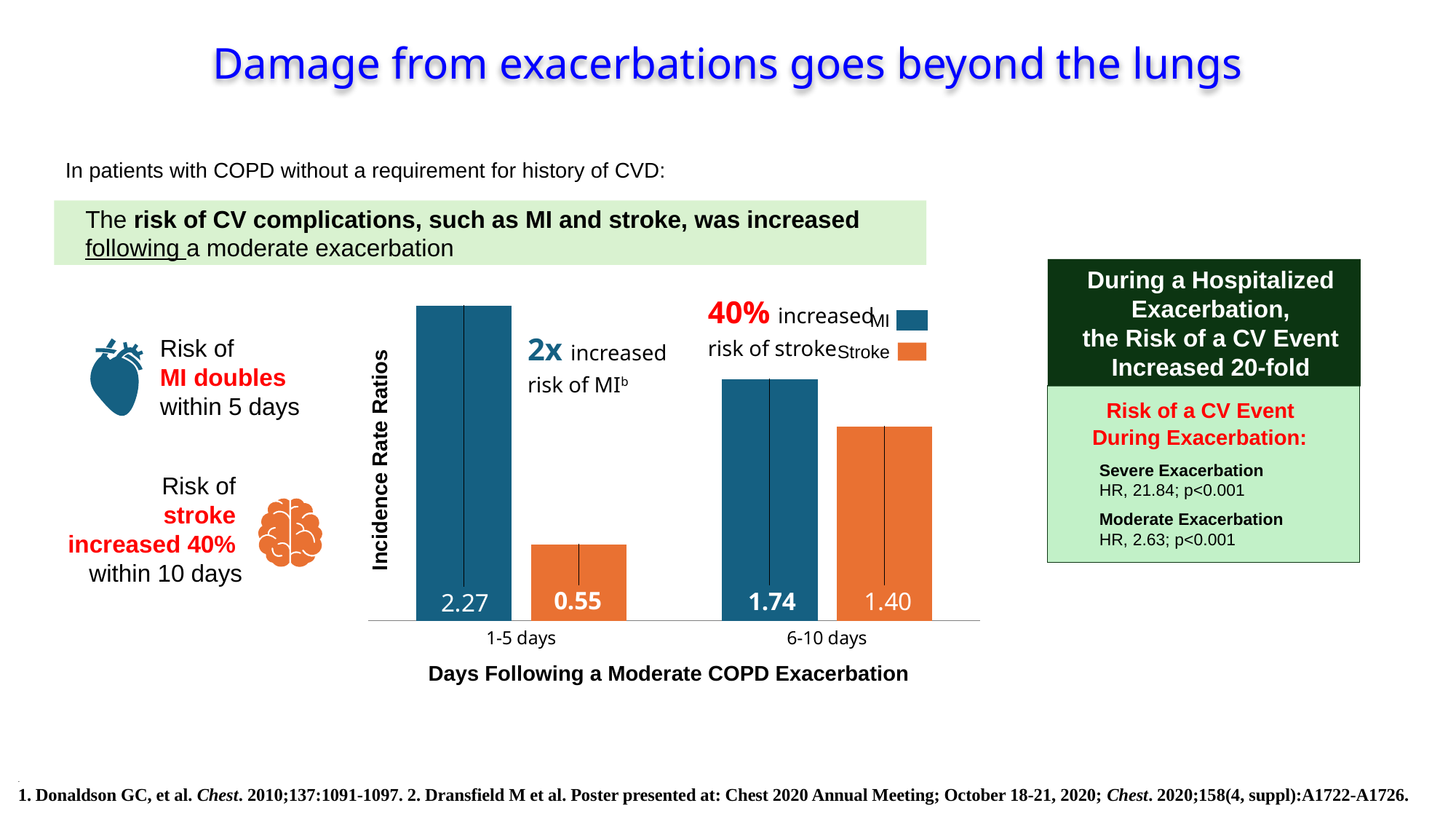
What kind of chart is shown? Bar chart Which bar has the lowest incidence rate ratio? Stroke at 1-5 days Which bar has the highest incidence rate ratio? MI at 1-5 days What is the difference between the MI and stroke incidence rate ratios at 1-5 days? 1.72 What is the incidence rate ratio for stroke at 6-10 days? 1.40 What is the incidence rate ratio for stroke at 1-5 days? 0.55 What is the incidence rate ratio for MI at 6-10 days? 1.74 What is the x-axis title of the chart? Days Following a Moderate COPD Exacerbation Which is larger at 6-10 days, the MI or the stroke incidence rate ratio? MI How many series does the legend list? 2 What is the incidence rate ratio for MI at 1-5 days? 2.27 How many categories are shown on the x axis? 2